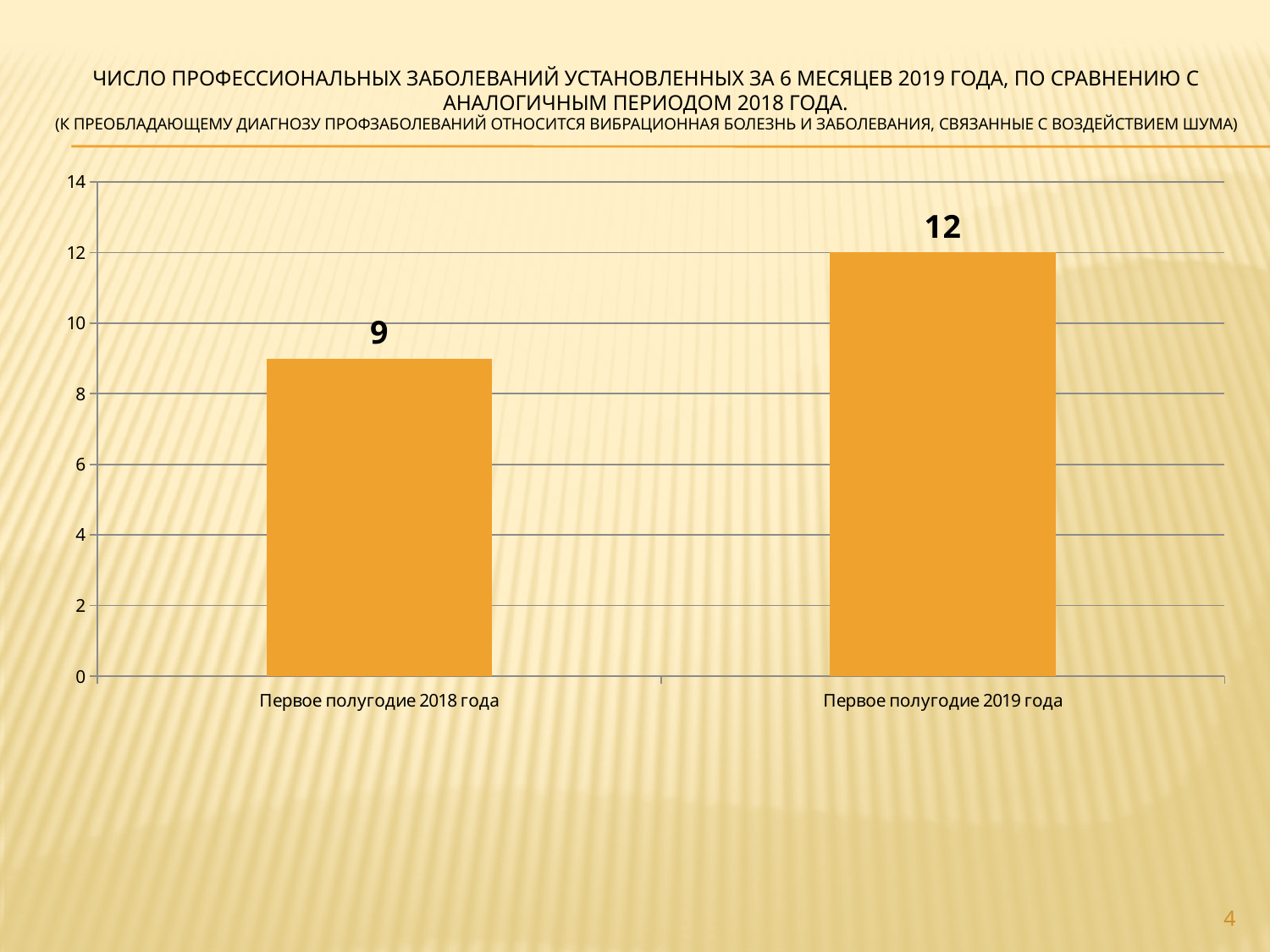
What is the value for Первое полугодие 2019 года? 12 Is the value for Первое полугодие 2018 года greater or less than 10? less Which is larger: the value for Первое полугодие 2018 года or for Первое полугодие 2019 года? Первое полугодие 2019 года Which category has the lowest value? Первое полугодие 2018 года Which category has the highest value? Первое полугодие 2019 года Is the value for Первое полугодие 2019 года greater or less than 10? greater What is the difference between the values for Первое полугодие 2019 года and Первое полугодие 2018 года? 3 What kind of chart is shown on the slide? bar chart What is the value for Первое полугодие 2018 года? 9 How many categories are shown on the x axis? 2 What is the maximum value shown on the vertical axis? 14 Do the values rise or fall from Первое полугодие 2018 года to Первое полугодие 2019 года? rise